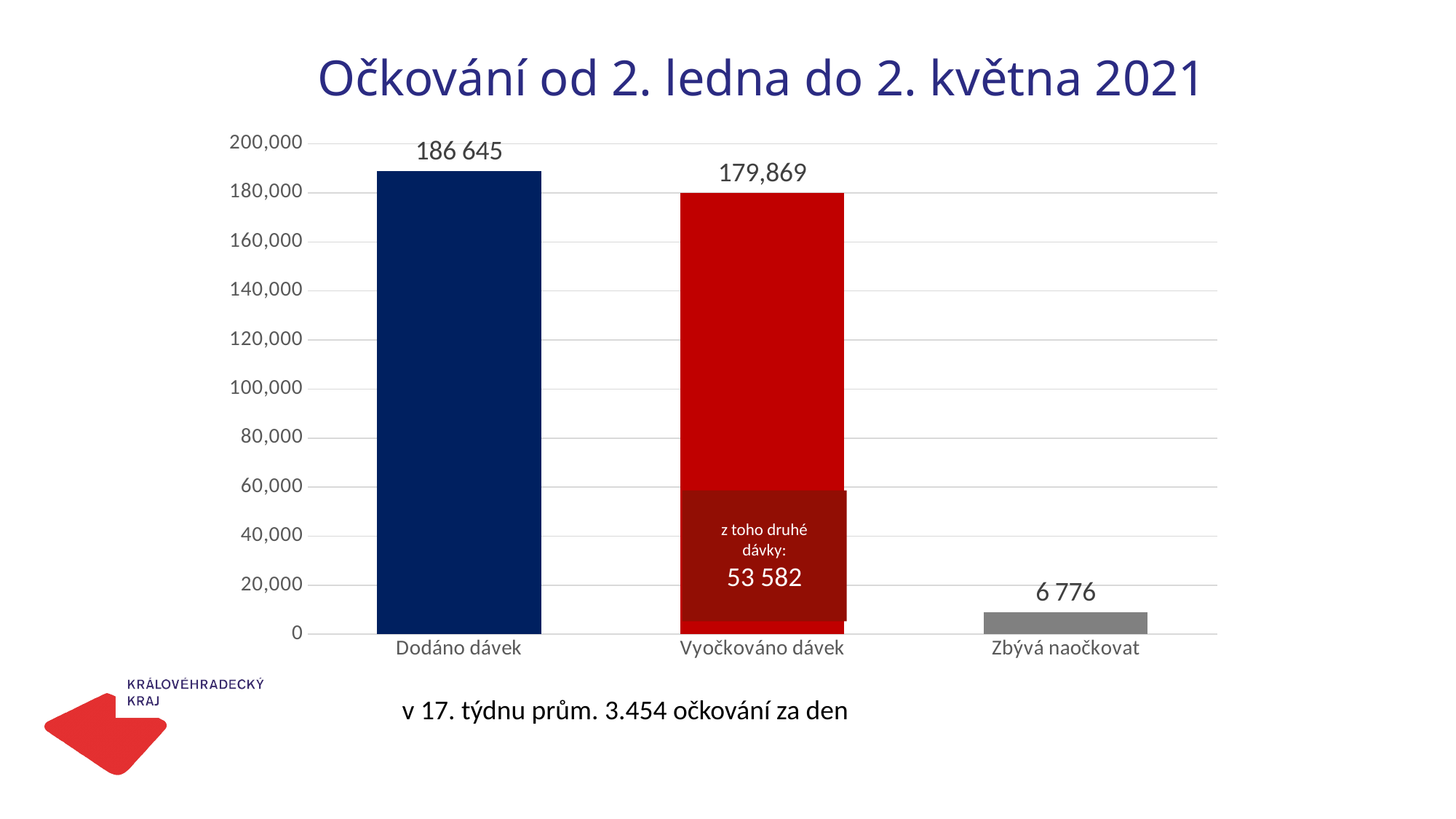
Which category has the highest value? Dodáno dávek What is the value for Zbývá naočkovat? 6 776 How many second doses (druhé dávky) are shown within the Vyočkováno dávek bar? 53 582 What is the value for Vyočkováno dávek? 179,869 What type of chart is shown on the slide? bar chart What is the value for Dodáno dávek? 186 645 How many categories are shown on the x axis? 3 Is the value for Zbývá naočkovat greater or less than 20,000? less What is the difference between Dodáno dávek (186 645) and Vyočkováno dávek (179,869)? 6 776 What is the title of the chart? Očkování od 2. ledna do 2. května 2021 Which category has the lowest value? Zbývá naočkovat Which is larger, Dodáno dávek or Vyočkováno dávek? Dodáno dávek